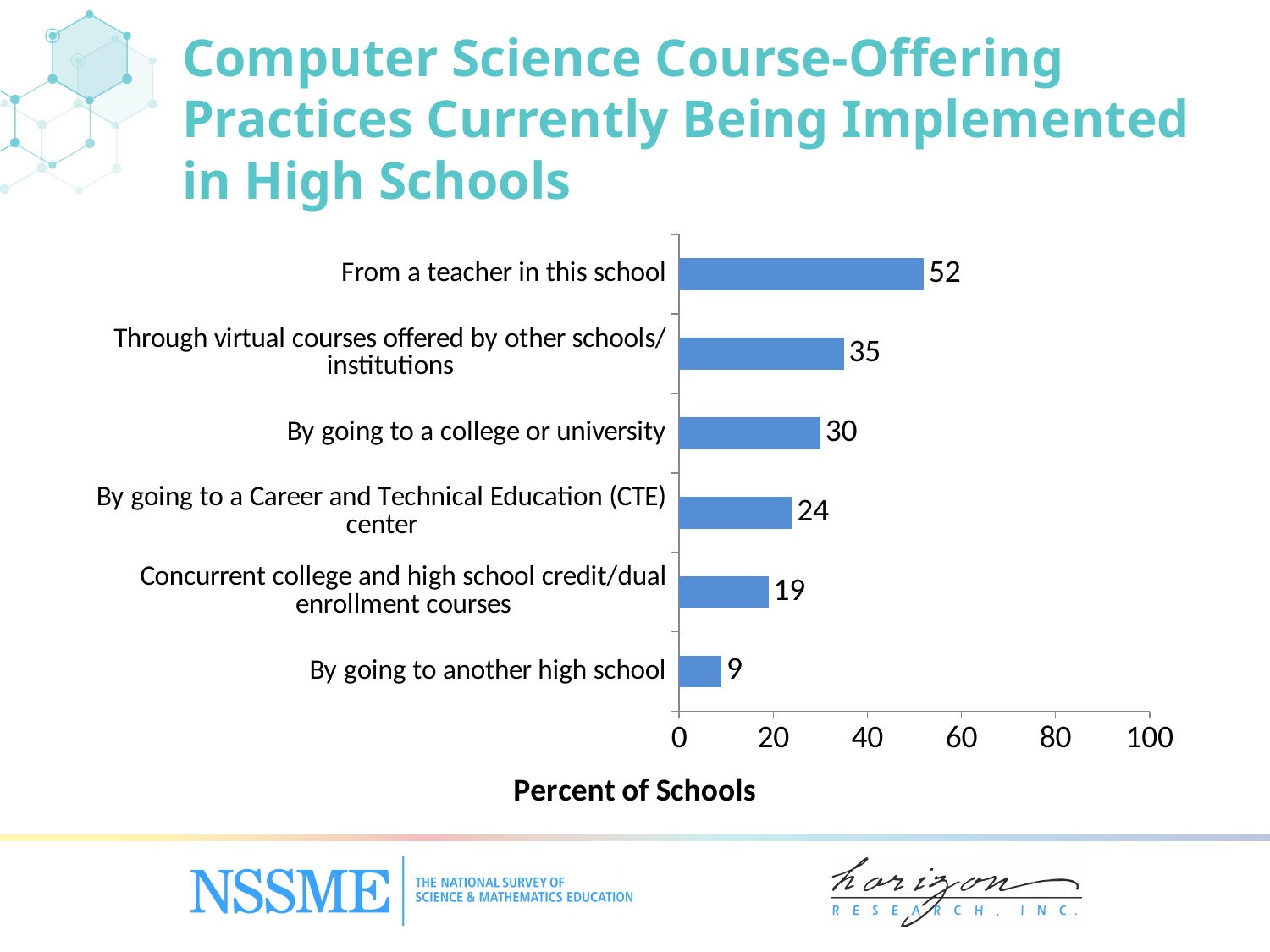
Which is larger: the value for 'By going to a college or university' or the value for 'By going to a Career and Technical Education (CTE) center'? By going to a college or university What kind of chart is shown on the slide? bar chart What is the difference between the values for 'From a teacher in this school' and 'Through virtual courses offered by other schools/institutions'? 17 What is the difference between the values for 'By going to a college or university' and 'By going to another high school'? 21 What percent of schools offer computer science courses from a teacher in this school? 52 What is the value for 'Concurrent college and high school credit/dual enrollment courses'? 19 What is the value for 'By going to a Career and Technical Education (CTE) center'? 24 How many course-offering practices are shown in the chart? 6 Which course-offering practice has the highest percent of schools? From a teacher in this school Is the value for 'Through virtual courses offered by other schools/institutions' greater or less than 40? less Which course-offering practice has the lowest percent of schools? By going to another high school What is the label of the horizontal axis? Percent of Schools